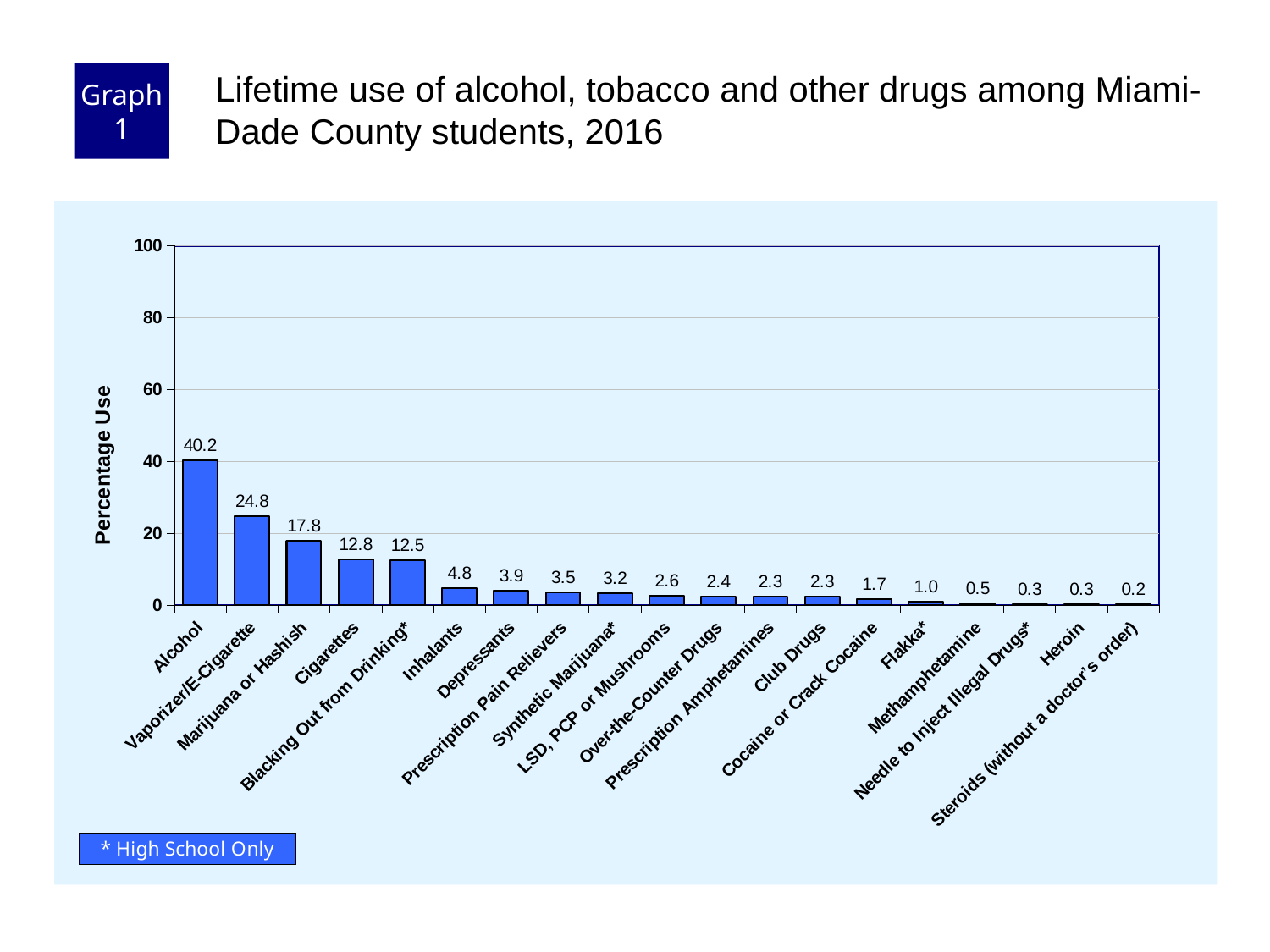
How many categories are shown on the chart? 19 What is the difference in percentage use between Alcohol and Vaporizer/E-Cigarette? 15.4 Which category has the lowest percentage use? Steroids (without a doctor's order) What is the label of the y axis? Percentage Use What is the percentage use for Alcohol? 40.2 What is the percentage use for Vaporizer/E-Cigarette? 24.8 What kind of chart is shown on the slide? Bar chart Which category has the highest percentage use? Alcohol What is the difference in percentage use between Cigarettes and Blacking Out from Drinking*? 0.3 What is the percentage use for Inhalants? 4.8 What is the percentage use for Flakka*? 1.0 Which has a higher percentage use, Marijuana or Hashish or Cigarettes? Marijuana or Hashish